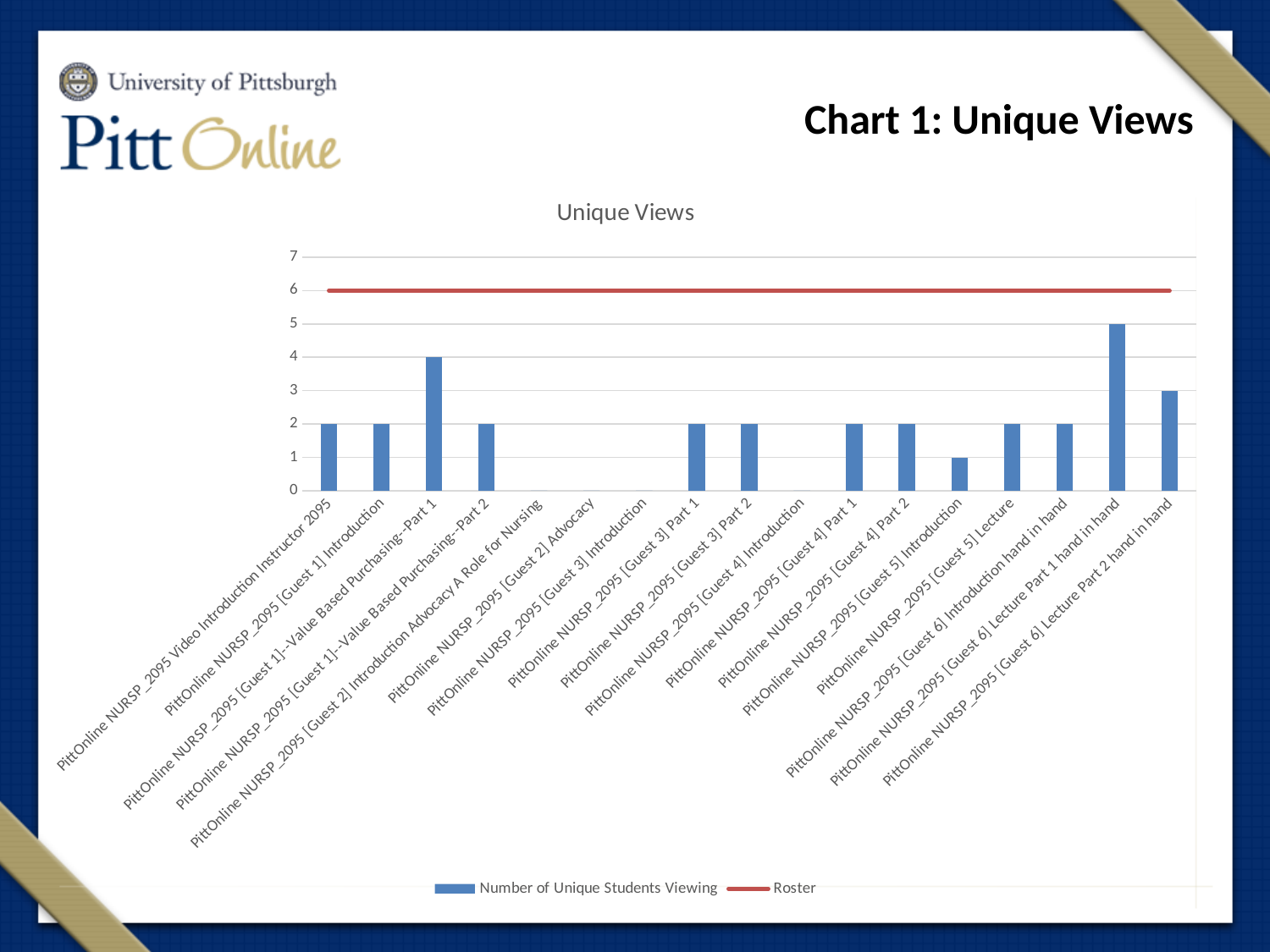
What is the difference between the number of unique students viewing for PittOnline NURSP_2095 [Guest 6] Lecture Part 1 hand in hand and PittOnline NURSP_2095 [Guest 6] Lecture Part 2 hand in hand? 2 What is the number of unique students viewing for PittOnline NURSP_2095 [Guest 5] Introduction? 1 What type of chart is shown on the slide? Combination bar and line chart Is the value for PittOnline NURSP_2095 [Guest 6] Lecture Part 1 hand in hand greater or less than the Roster value of 6? less Which has more unique students viewing: PittOnline NURSP_2095 [Guest 1]--Value Based Purchasing--Part 1 or PittOnline NURSP_2095 [Guest 1]--Value Based Purchasing--Part 2? PittOnline NURSP_2095 [Guest 1]--Value Based Purchasing--Part 1 What is the title of the chart? Unique Views What value does the Roster line sit at? 6 What is the number of unique students viewing for PittOnline NURSP_2095 [Guest 6] Lecture Part 1 hand in hand? 5 How many series does the legend list? 2 How many categories are shown on the x axis? 17 Which category has the highest number of unique students viewing? PittOnline NURSP_2095 [Guest 6] Lecture Part 1 hand in hand What is the number of unique students viewing for PittOnline NURSP_2095 [Guest 1]--Value Based Purchasing--Part 1? 4